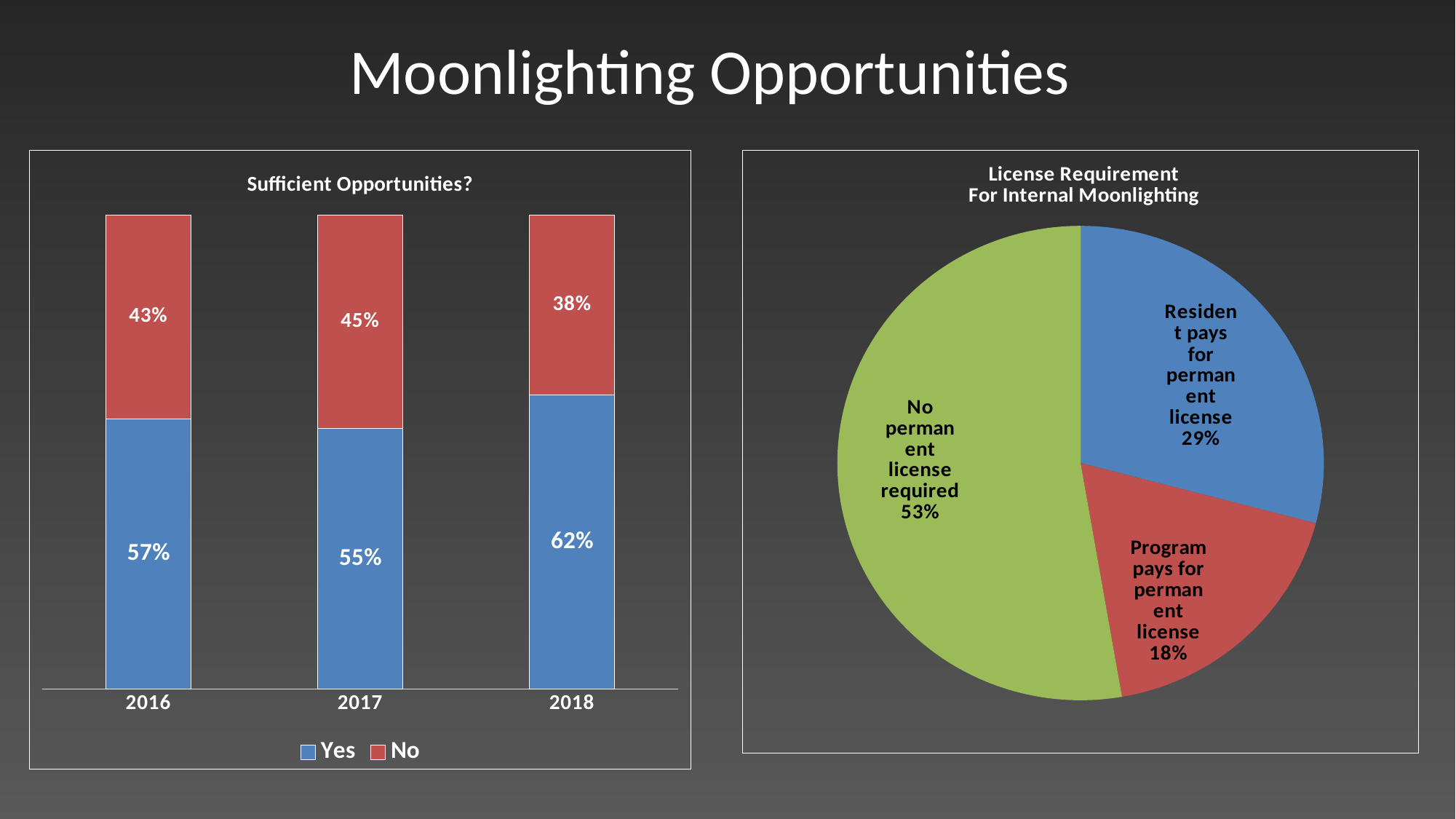
In the "Sufficient Opportunities?" chart, which year has the lowest No value? 2018 In the "License Requirement For Internal Moonlighting" chart, which slice is the smallest? Program pays for permanent license In the "Sufficient Opportunities?" chart, what is the value for Yes in 2018? 62% In the "Sufficient Opportunities?" chart, what is the difference between the Yes values for 2018 and 2017? 7% What kind of chart is the "Sufficient Opportunities?" chart? stacked bar chart In the "Sufficient Opportunities?" chart, what is the value for No in 2017? 45% In the "License Requirement For Internal Moonlighting" chart, what share is "No permanent license required"? 53% In the "Sufficient Opportunities?" chart, how many years are shown on the x axis? 3 In the "License Requirement For Internal Moonlighting" chart, what colour is the "Resident pays for permanent license" slice? blue In the "Sufficient Opportunities?" chart, how many series does the legend list? 2 In the "Sufficient Opportunities?" chart, is the Yes value for 2016 larger or smaller than the Yes value for 2017? larger In the "Sufficient Opportunities?" chart, which year has the highest Yes value? 2018